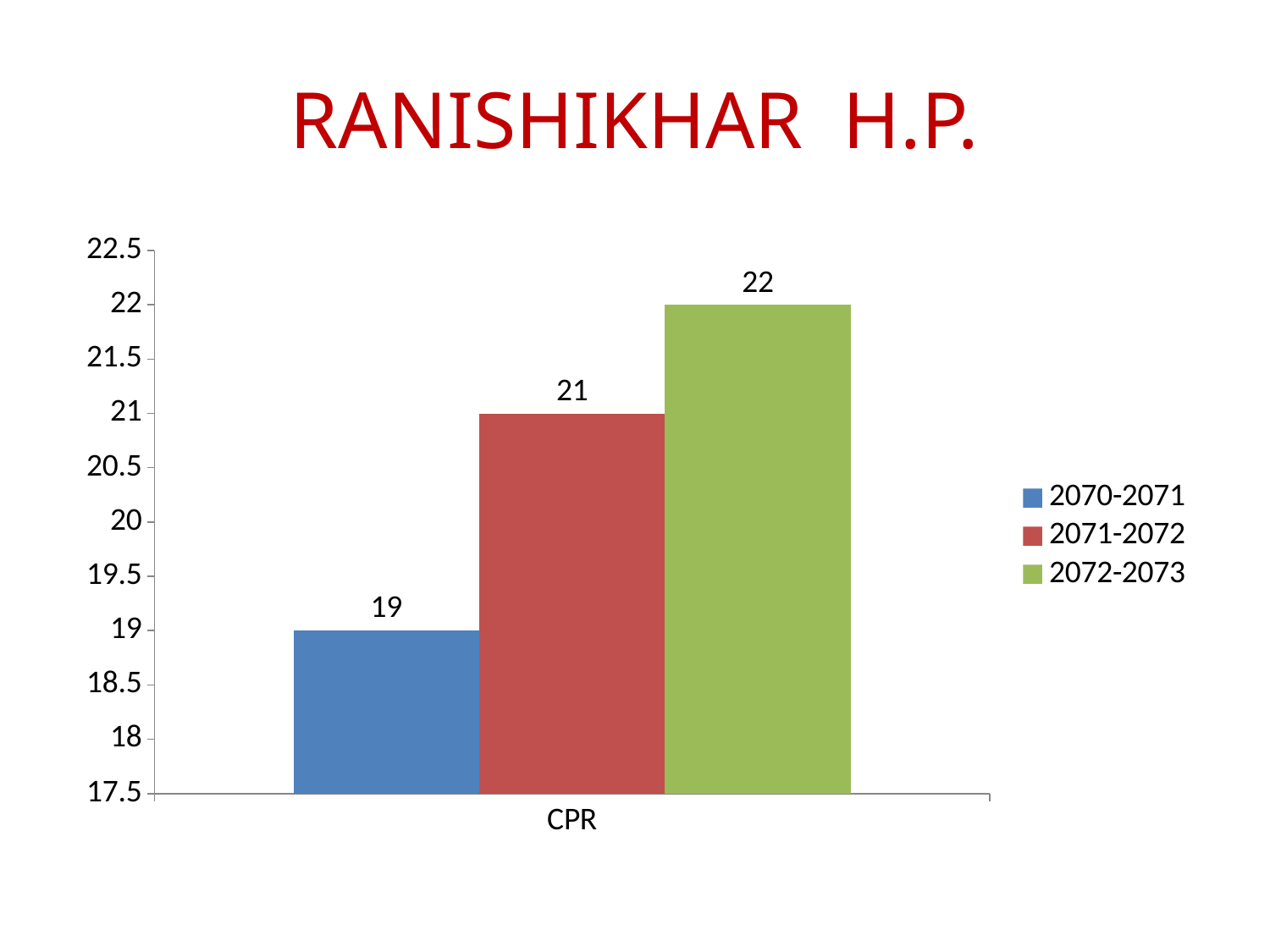
Which is larger, the CPR value for 2071-2072 or for 2072-2073? 2072-2073 How many series does the legend list? 3 Which series has the highest CPR value? 2072-2073 What is the difference between the CPR values for 2071-2072 and 2070-2071? 2 Which series has the lowest CPR value? 2070-2071 Do the CPR values rise or fall from 2070-2071 to 2072-2073? rise What is the CPR value for 2070-2071? 19 What kind of chart is shown on the slide? bar chart What is the CPR value for 2072-2073? 22 What is the difference between the CPR values for 2072-2073 and 2070-2071? 3 Is the CPR value for 2070-2071 greater or less than 20? less What is the CPR value for 2071-2072? 21